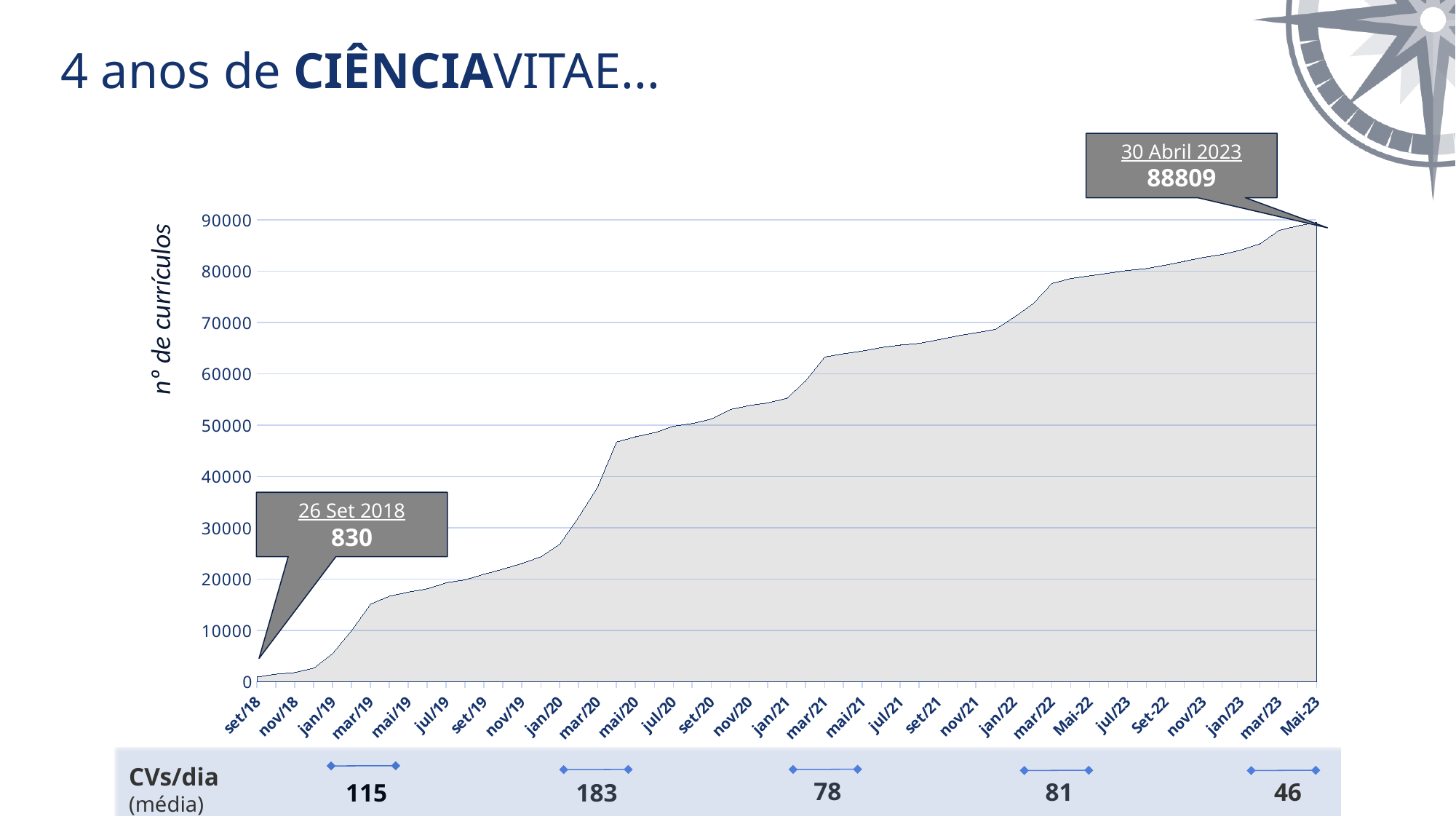
What is the highest tick shown on the y axis? 90000 What value does the callout give for 30 Abril 2023? 88809 What kind of chart is shown on the slide? area chart Which of the CVs/dia (média) values shown below the chart is the lowest? 46 Is the value for mar/19 greater or less than 20000? less Is the value for mar/22 greater or less than 70000? greater Which of the CVs/dia (média) values shown below the chart is the highest? 183 What is the label of the y axis? nº de currículos What value does the callout give for 26 Set 2018? 830 Is the value for mai/20 greater or less than 40000? greater What is the difference between the value on 30 Abril 2023 and the value on 26 Set 2018? 87979 Do the values rise or fall along the x axis from set/18 to Mai-23? rise